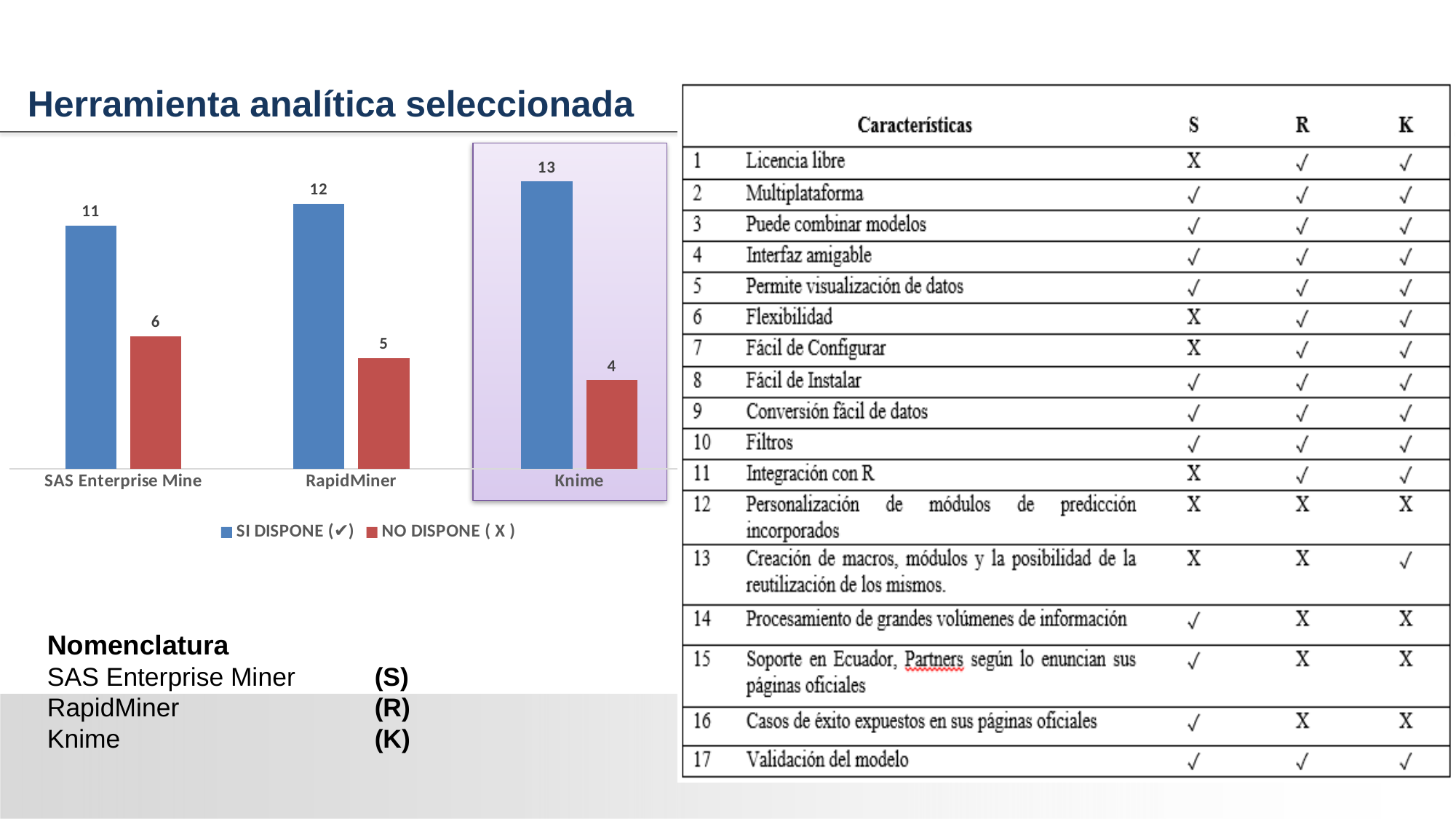
Which colour represents the NO DISPONE ( X ) series in the chart? Red What is the NO DISPONE value for SAS Enterprise Mine? 6 Which tool has the highest SI DISPONE value? Knime Do the SI DISPONE values rise or fall from left to right across the x axis? Rise How many series does the chart legend list? 2 Which tool has the lowest NO DISPONE value? Knime What is the SI DISPONE value for Knime? 13 Which is larger: the NO DISPONE value for SAS Enterprise Mine or for RapidMiner? SAS Enterprise Mine What is the difference between the SI DISPONE values for Knime and SAS Enterprise Mine? 2 What is the NO DISPONE value for RapidMiner? 5 How many tools (categories) are shown on the x axis of the chart? 3 What kind of chart is shown on the slide? Bar chart